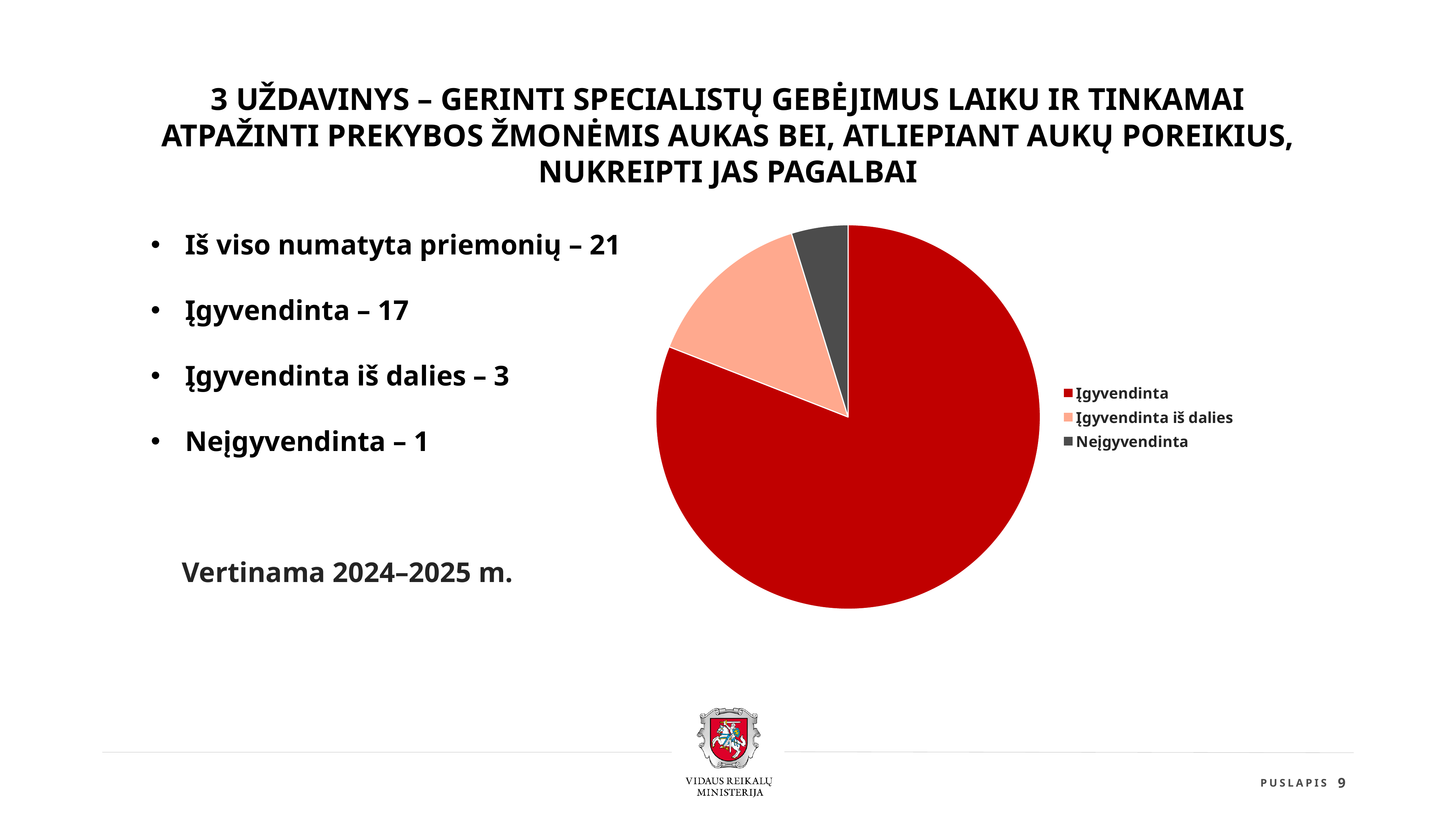
How many measures are reported as Įgyvendinta? 17 How many entries does the legend of the pie chart list? 3 What colour is the Įgyvendinta slice in the pie chart? red How many measures are reported as Neįgyvendinta? 1 How many slices does the pie chart have? 3 Which category has the largest slice in the pie chart? Įgyvendinta What kind of chart is shown on the slide? pie chart How many measures are reported as Įgyvendinta iš dalies? 3 What is the difference between the number of measures Įgyvendinta and Įgyvendinta iš dalies? 14 Which slice is larger: Įgyvendinta iš dalies or Neįgyvendinta? Įgyvendinta iš dalies Which slice is larger: Įgyvendinta or Įgyvendinta iš dalies? Įgyvendinta Which category has the smallest slice in the pie chart? Neįgyvendinta